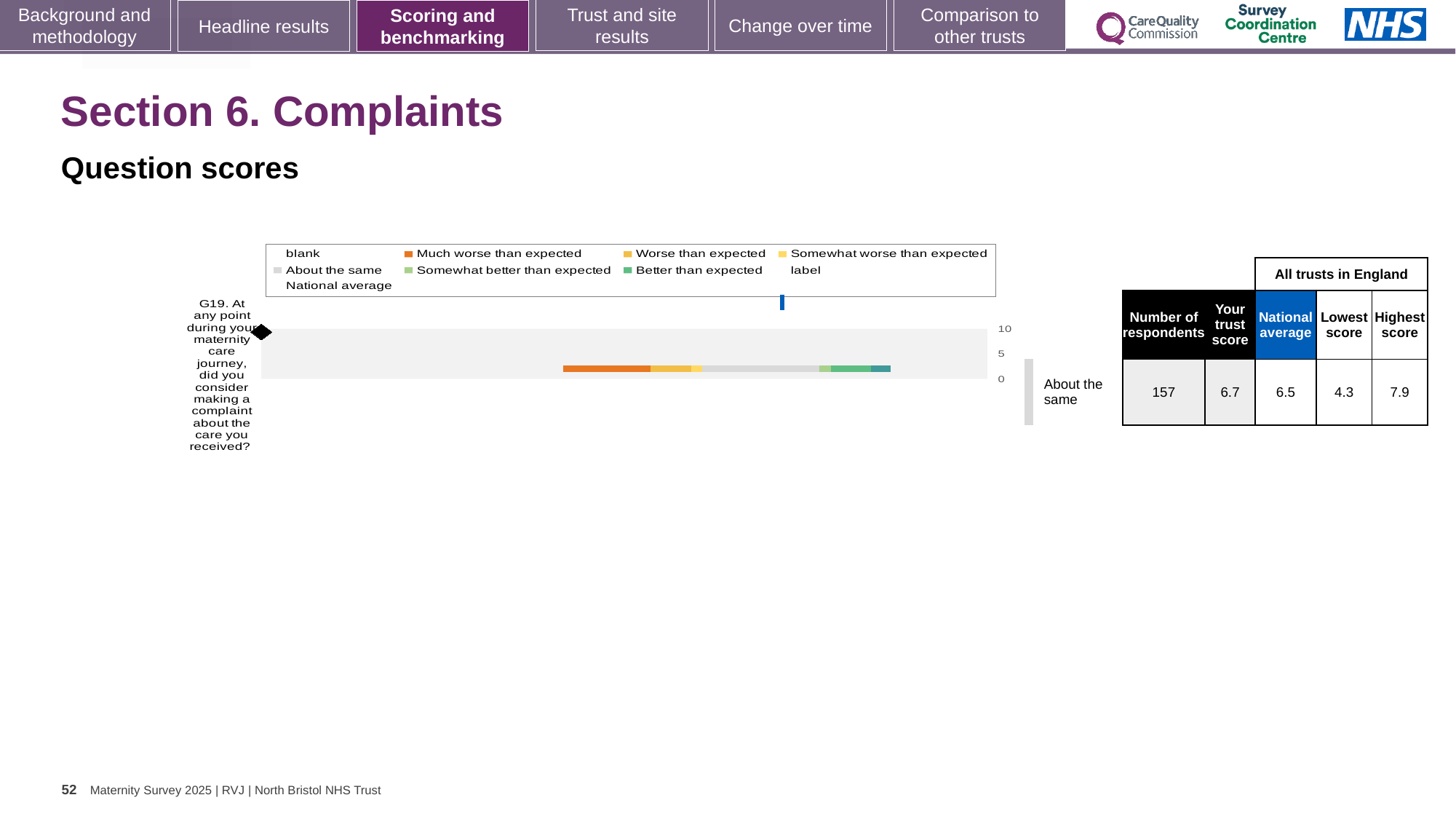
What is the trust's score for question G19 shown next to the chart? 6.7 How many questions (categories) are plotted on the chart? 1 What is the difference between the trust score and the national average for question G19? 0.2 What benchmark category is the trust's G19 score placed in, as labelled beside the chart? About the same What is the national average score for question G19? 6.5 Which is larger for question G19: the trust score or the national average? trust score How many respondents answered question G19? 157 Is the trust score for question G19 greater or less than 5 on the chart's axis? greater What is the difference between the highest and lowest scores across all trusts for question G19? 3.6 What is the lowest score among all trusts in England for question G19? 4.3 What is the highest score among all trusts in England for question G19? 7.9 What kind of chart is used to show the G19 question score? bar chart